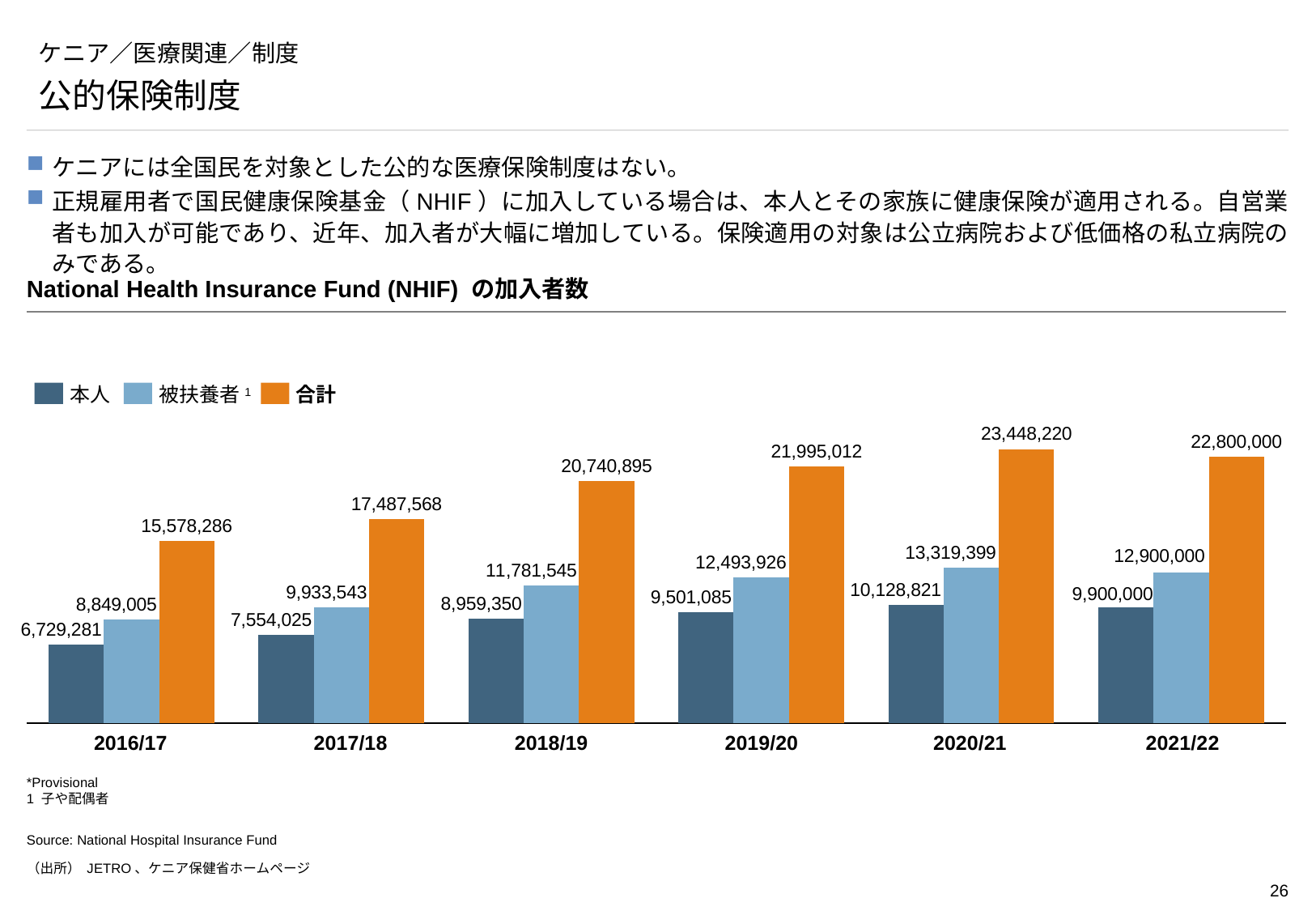
How many series does the legend list? 3 What is the value of 本人 for 2021/22? 9,900,000 What kind of chart is shown? Bar chart What is the value of 被扶養者 for 2019/20? 12,493,926 In which year is 本人 lowest? 2016/17 What is the value of 本人 for 2016/17? 6,729,281 Which is larger: 被扶養者 in 2020/21 or 被扶養者 in 2021/22? 被扶養者 in 2020/21 What is the difference between 合計 in 2020/21 and 合計 in 2021/22? 648,220 What is the difference between 本人 in 2017/18 and 本人 in 2016/17? 824,744 How many years are shown on the x axis? 6 What is the value of 合計 for 2018/19? 20,740,895 In which year is 合計 highest? 2020/21